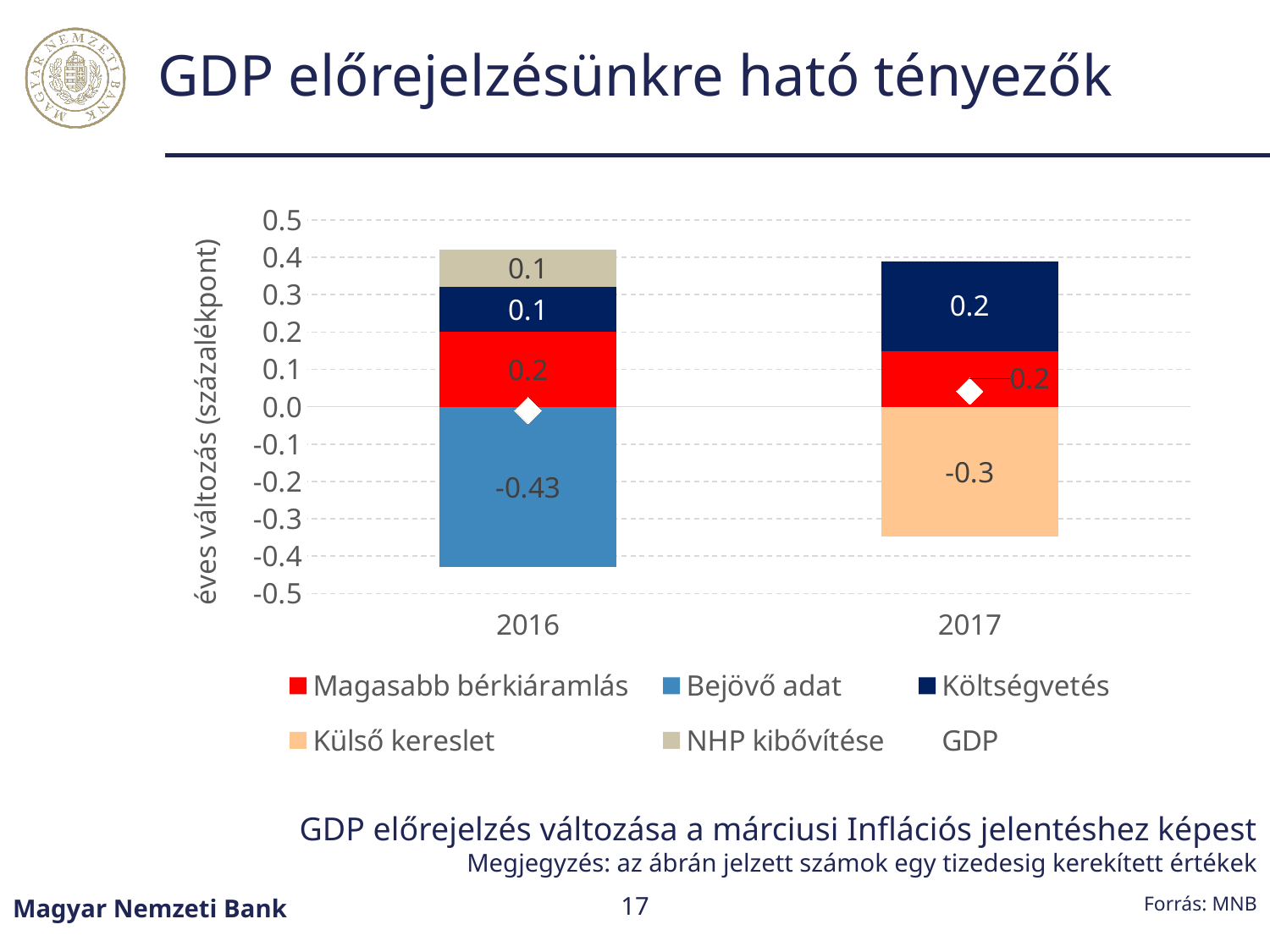
What is the value of Külső kereslet in 2017? -0.3 What is the value of Magasabb bérkiáramlás in 2016? 0.2 What kind of chart is shown on the slide? stacked bar chart What is the value of NHP kibővítése in 2016? 0.1 What is the value of Költségvetés in 2017? 0.2 By how much does the Költségvetés value in 2017 exceed the value in 2016? 0.1 How many series does the legend list? 6 Is the GDP marker for 2017 greater or less than 0.1? less Is the Költségvetés contribution larger in 2016 or in 2017? 2017 How many years (categories) are shown on the x axis? 2 What is the value of Bejövő adat in 2016? -0.43 What is the label of the vertical axis? éves változás (százalékpont)